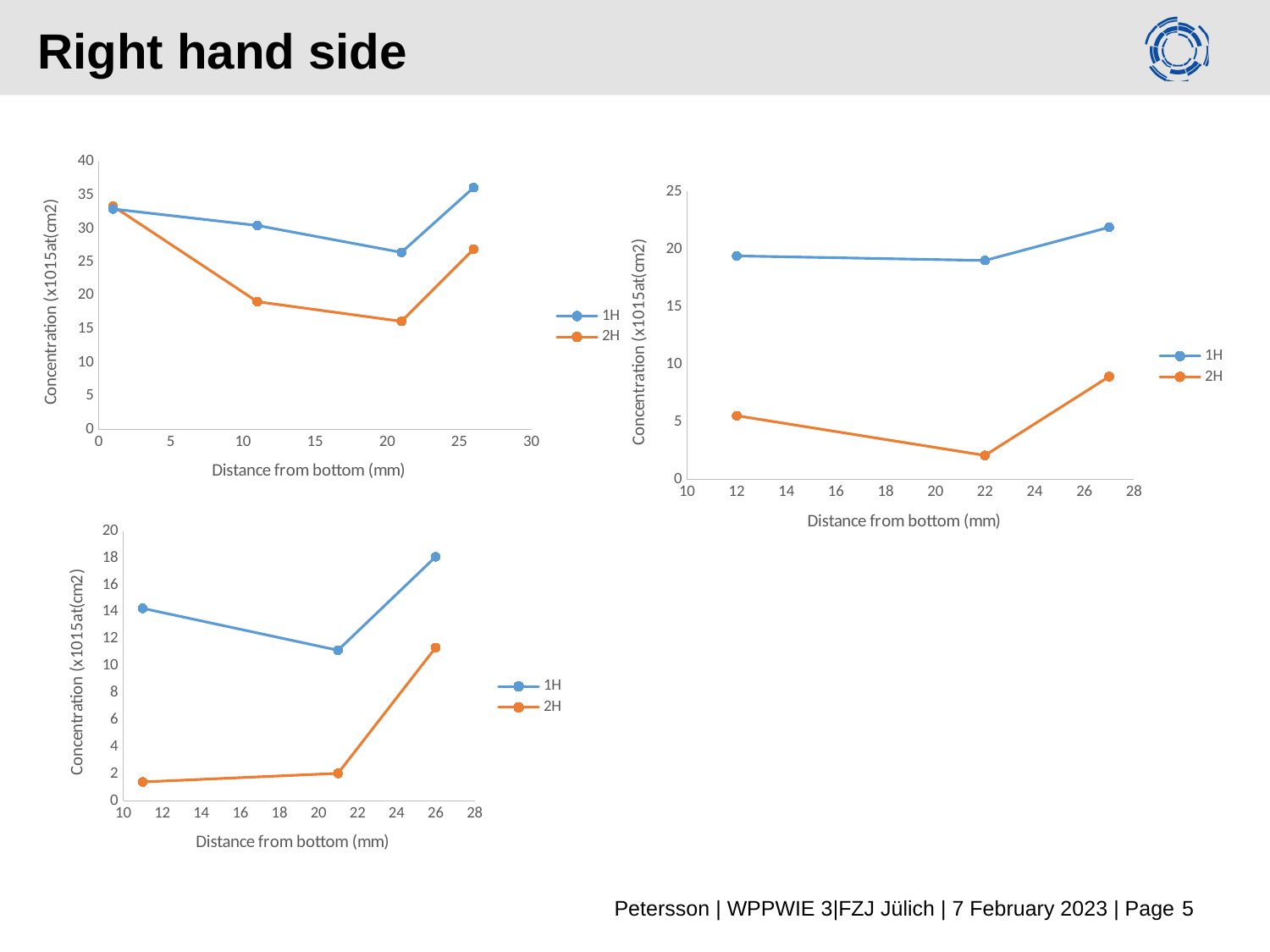
How many data points does the 1H series have in the top-left chart? 4 What is the x-axis title of the top-right chart? Distance from bottom (mm) In the bottom-left chart, is the 1H value at 21 mm greater or less than 12? less In the top-right chart, is the 1H value at 27 mm greater or less than 20? greater In the bottom-left chart, which series has the higher value at 26 mm, 1H or 2H? 1H How many data points does the 2H series have in the bottom-left chart? 3 In the top-left chart, is the 1H value at 26 mm greater or less than 35? greater How many series does the legend of the top-right chart list? 2 What kind of chart is the top-left chart? line chart In the bottom-left chart, at which distance from bottom does the 2H series reach its highest value? 26